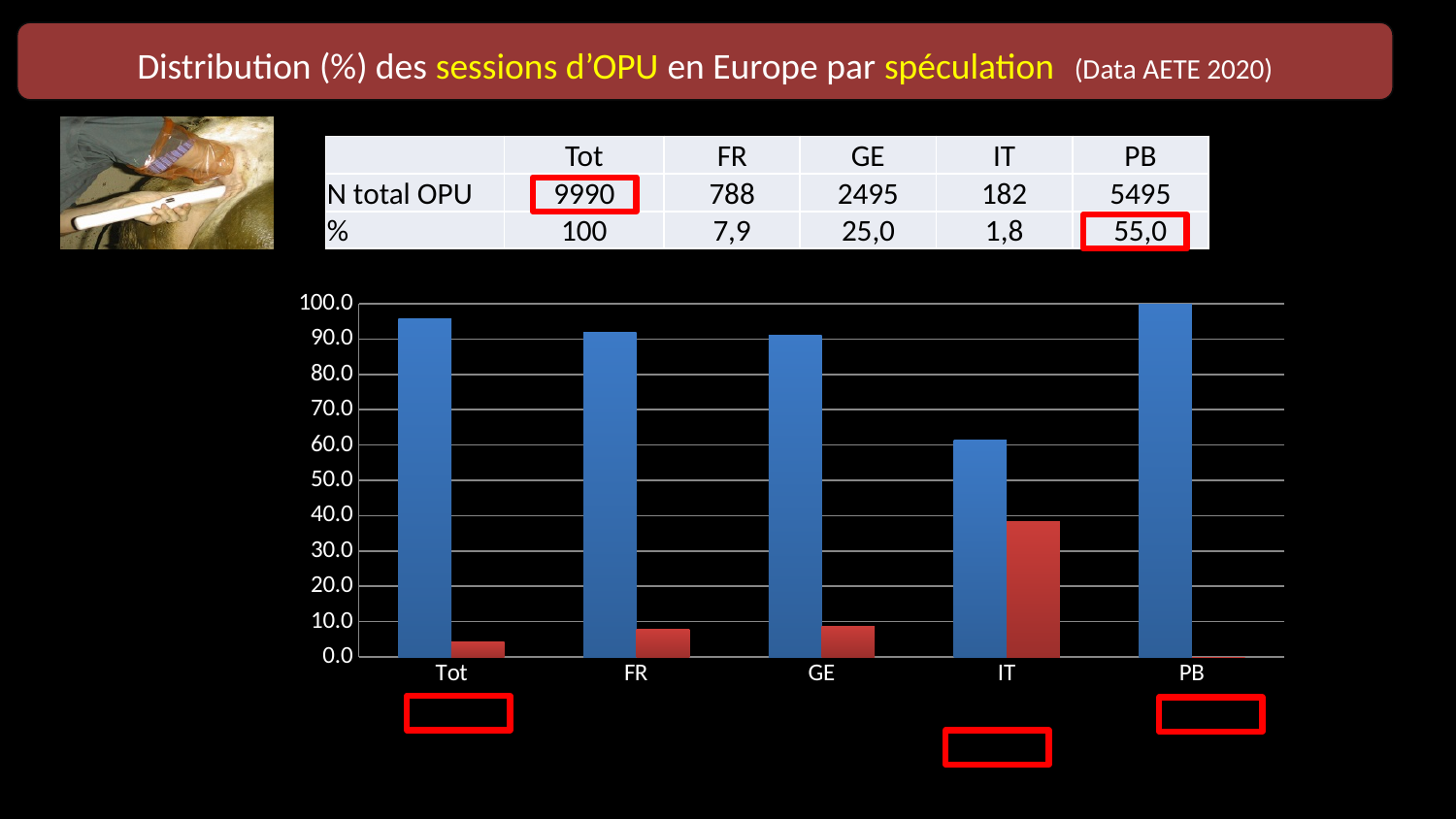
Which category has the tallest red bar? IT Which category has the shortest blue bar? IT Which is larger, the red bar for IT or the red bar for FR? IT Which is larger, the blue bar for Tot or the blue bar for IT? Tot Is the blue bar for FR greater or less than 80.0? greater What is the highest value shown on the y axis of the chart? 100.0 How many categories are shown on the x axis of the chart? 5 Which category has the tallest blue bar? PB Is the red bar for IT greater or less than 30.0? greater What kind of chart is shown on the slide? bar chart Is the blue bar for IT greater or less than 70.0? less